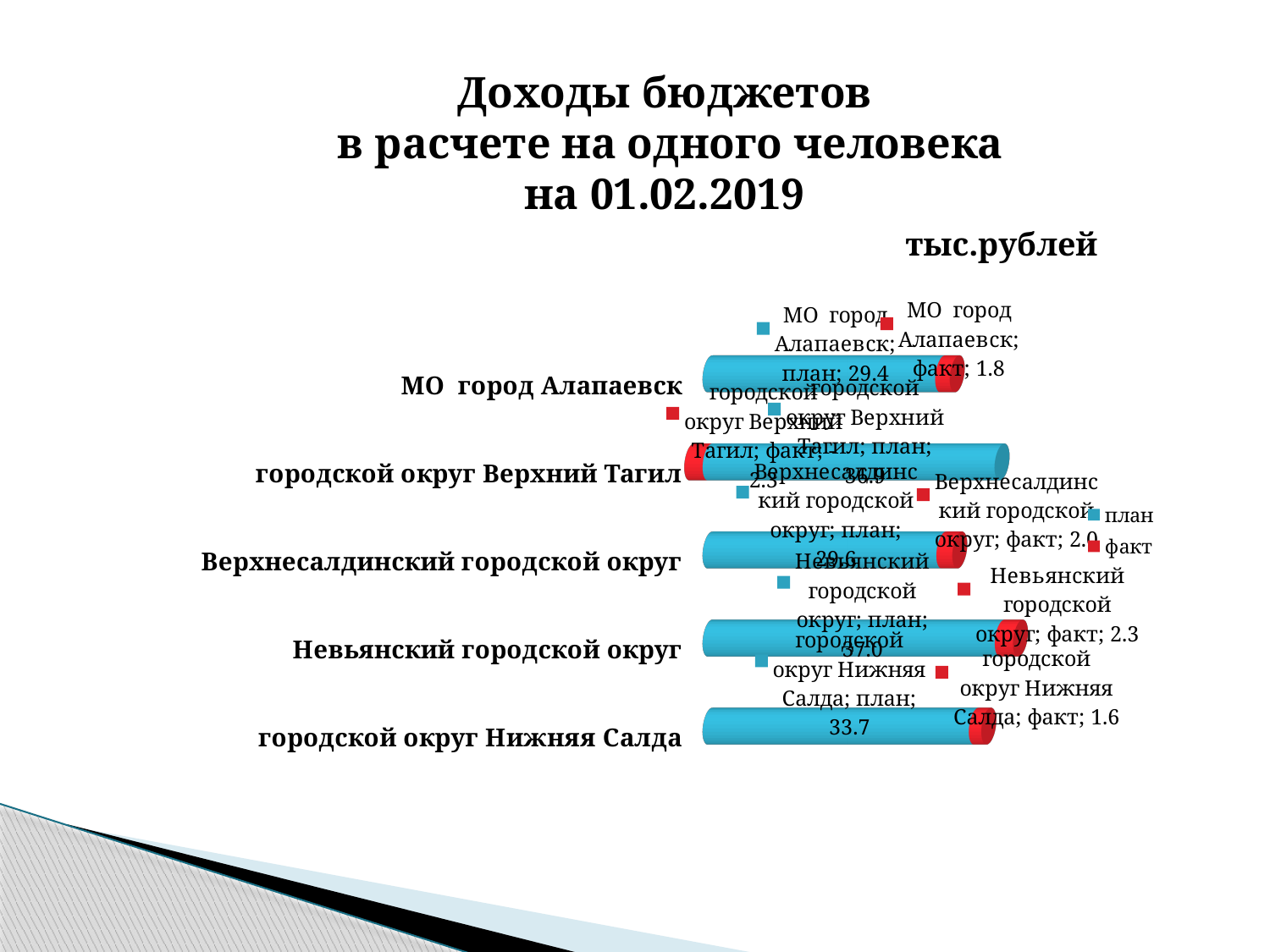
How many municipalities (categories) are shown in the chart? 5 Which is larger: the план value for городской округ Нижняя Салда or the план value for МО город Алапаевск? городской округ Нижняя Салда What is the факт value for МО город Алапаевск? 1.8 What is the план value for МО город Алапаевск? 29.4 Which municipality has the lowest факт value? городской округ Верхний Тагил How many series does the chart legend list? 2 What kind of chart is shown on the slide? bar chart What are the two series named in the legend? план and факт What is the difference between the план and факт values for МО город Алапаевск? 27.6 What is the факт value for городской округ Нижняя Салда? 1.6 What is the факт value for Верхнесалдинский городской округ? 2.0 What is the план value for городской округ Нижняя Салда? 33.7